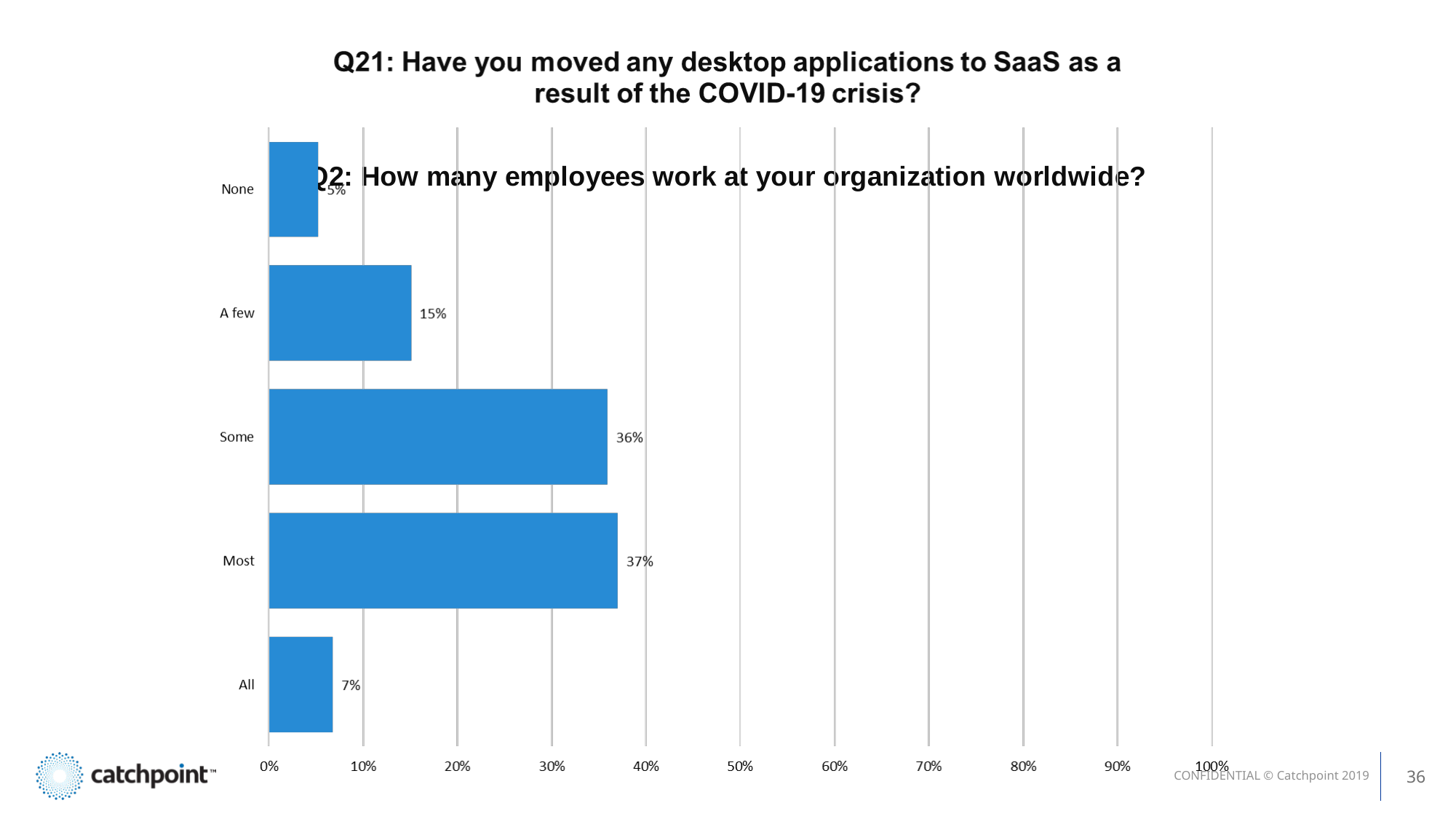
How many response categories are shown on the chart? 5 Which response category has the highest percentage? Most Is the value for "None" greater or less than 10%? less What percentage of respondents answered "Some" to Q21? 36% Which is larger, the value for "A few" or the value for "All"? A few What type of chart is shown on the slide? Bar chart What is the value shown for the "A few" category? 15% What is the difference between the "Most" and "Some" percentages? 1% What is the difference between the "A few" and "All" percentages? 8% What is the value shown for the "All" category? 7% Which response category has the lowest percentage? None What percentage of respondents answered "Most"? 37%